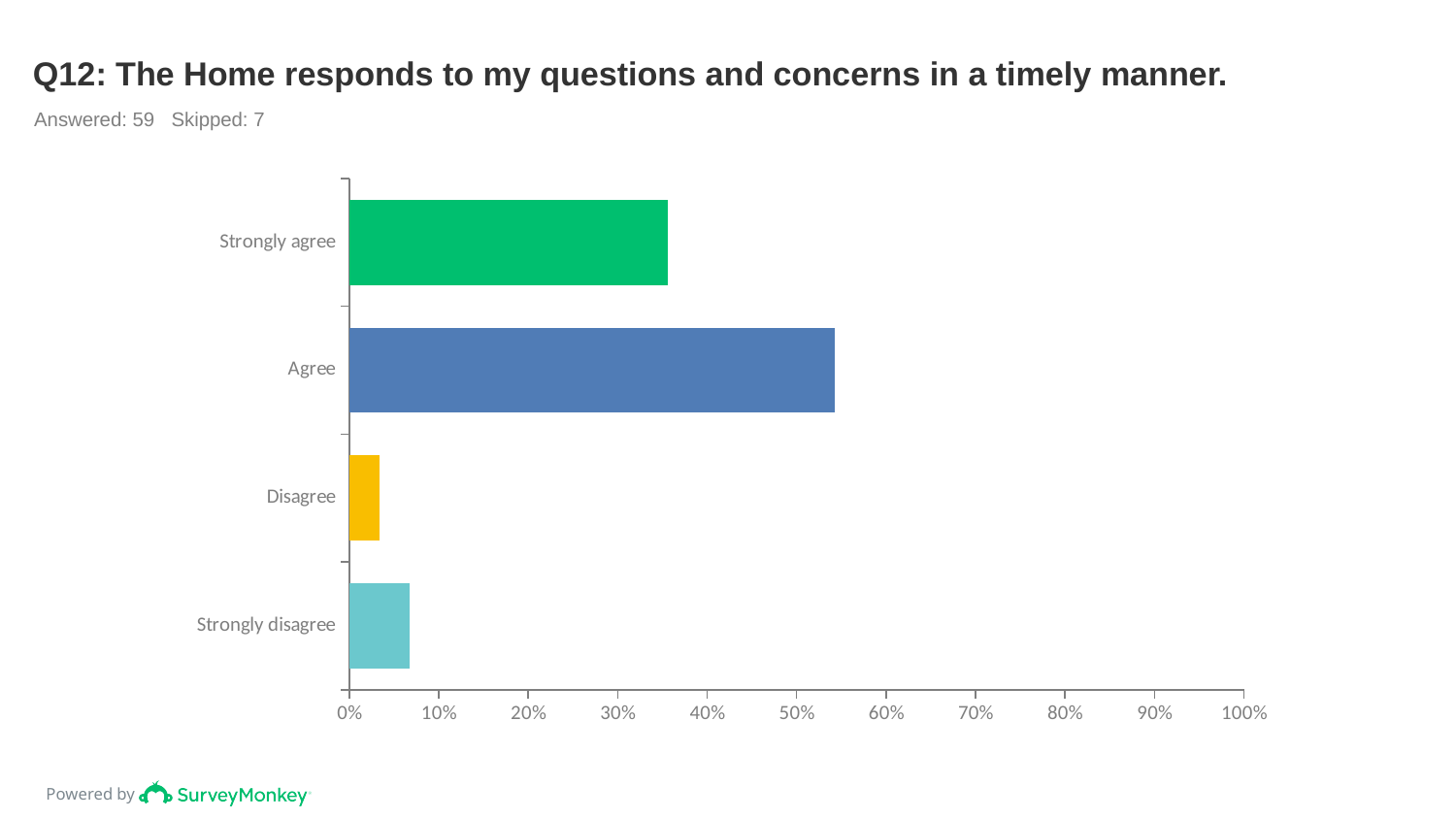
Is the value for Strongly disagree greater or less than 10%? less Which response category has the lowest value? Disagree Is the value for Agree greater or less than 50%? greater Is the value for Strongly agree greater or less than 40%? less Which is larger, the value for Strongly agree or the value for Agree? Agree What kind of chart is shown on the slide? Bar chart How many response categories are plotted in the chart? 4 Which is larger, the value for Disagree or the value for Strongly disagree? Strongly disagree How many respondents answered this question according to the slide? 59 What is the title of the chart? Q12: The Home responds to my questions and concerns in a timely manner. Which response category has the highest value? Agree